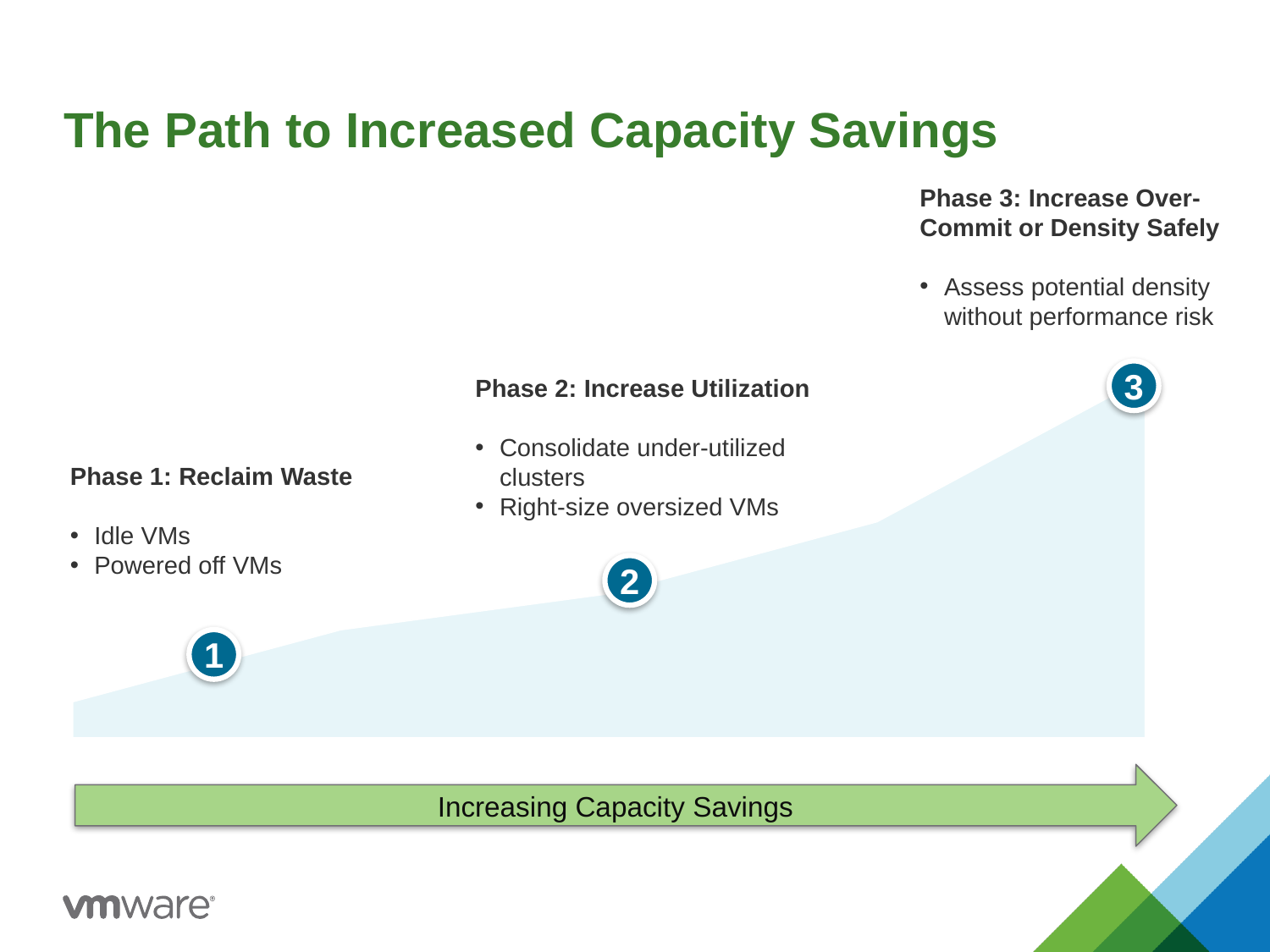
Which phase marker sits at the highest point of the shaded area? 3 What label is written on the green arrow beneath the shaded area? Increasing Capacity Savings Is marker 2 positioned higher or lower on the shaded area than marker 1? higher How many numbered phase markers are placed along the rising shaded area on the slide? 3 Which phase is labelled 'Increase Utilization'? Phase 2 Does the shaded area on the slide rise or fall from left to right? rise Which phase marker sits at the lowest point of the shaded area? 1